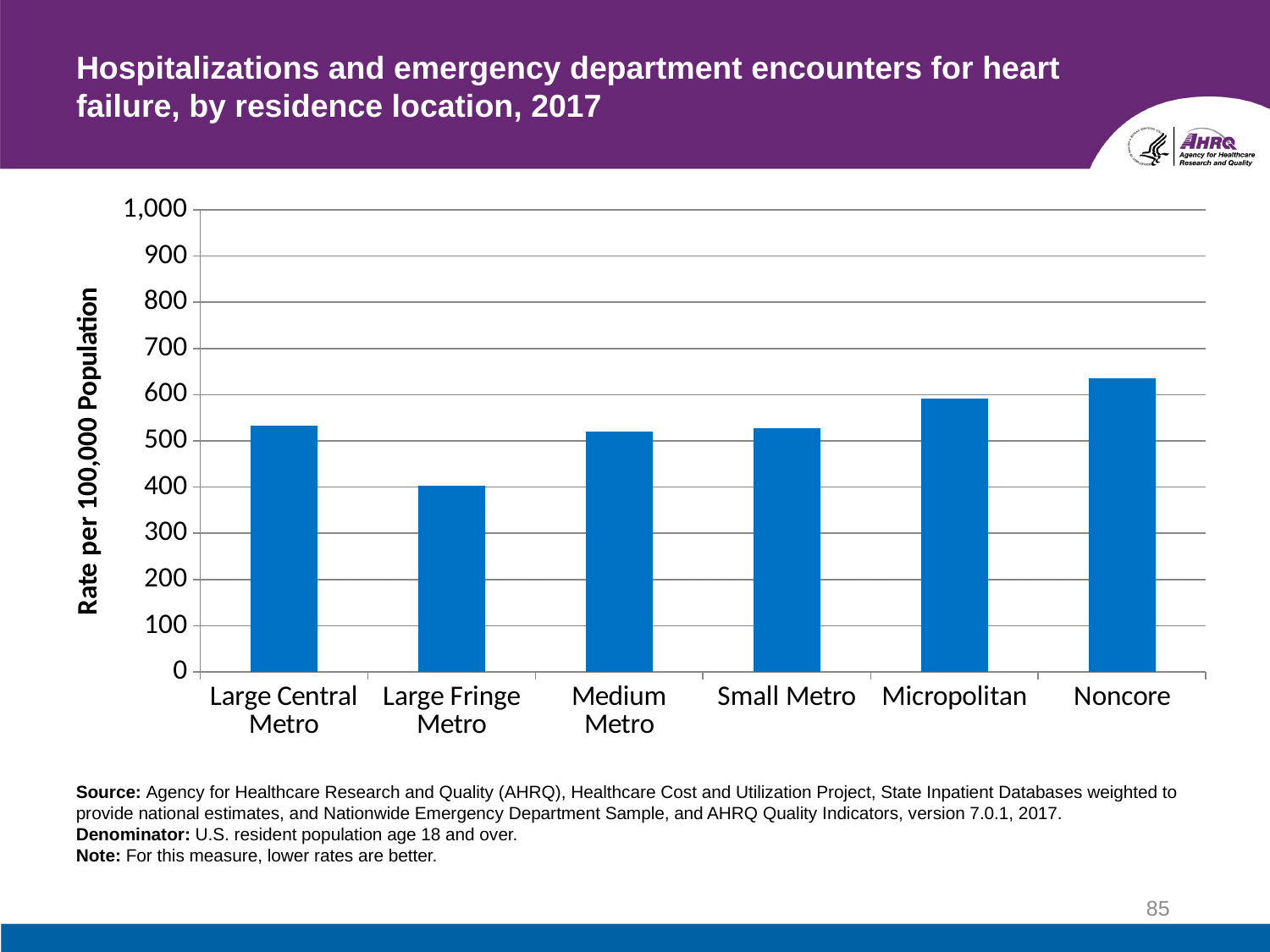
Is the value for Large Fringe Metro greater or less than 500? less Is the value for Small Metro greater or less than 600? less Is the value for Noncore greater or less than 600? greater Which residence location has the highest rate per 100,000 population? Noncore What is the label on the vertical axis of the chart? Rate per 100,000 Population Which residence location has the lowest rate per 100,000 population? Large Fringe Metro What kind of chart is shown on the slide? Bar chart Which has a higher rate, Large Fringe Metro or Noncore? Noncore How many residence location categories are shown on the x axis? 6 Which has a higher rate, Micropolitan or Medium Metro? Micropolitan